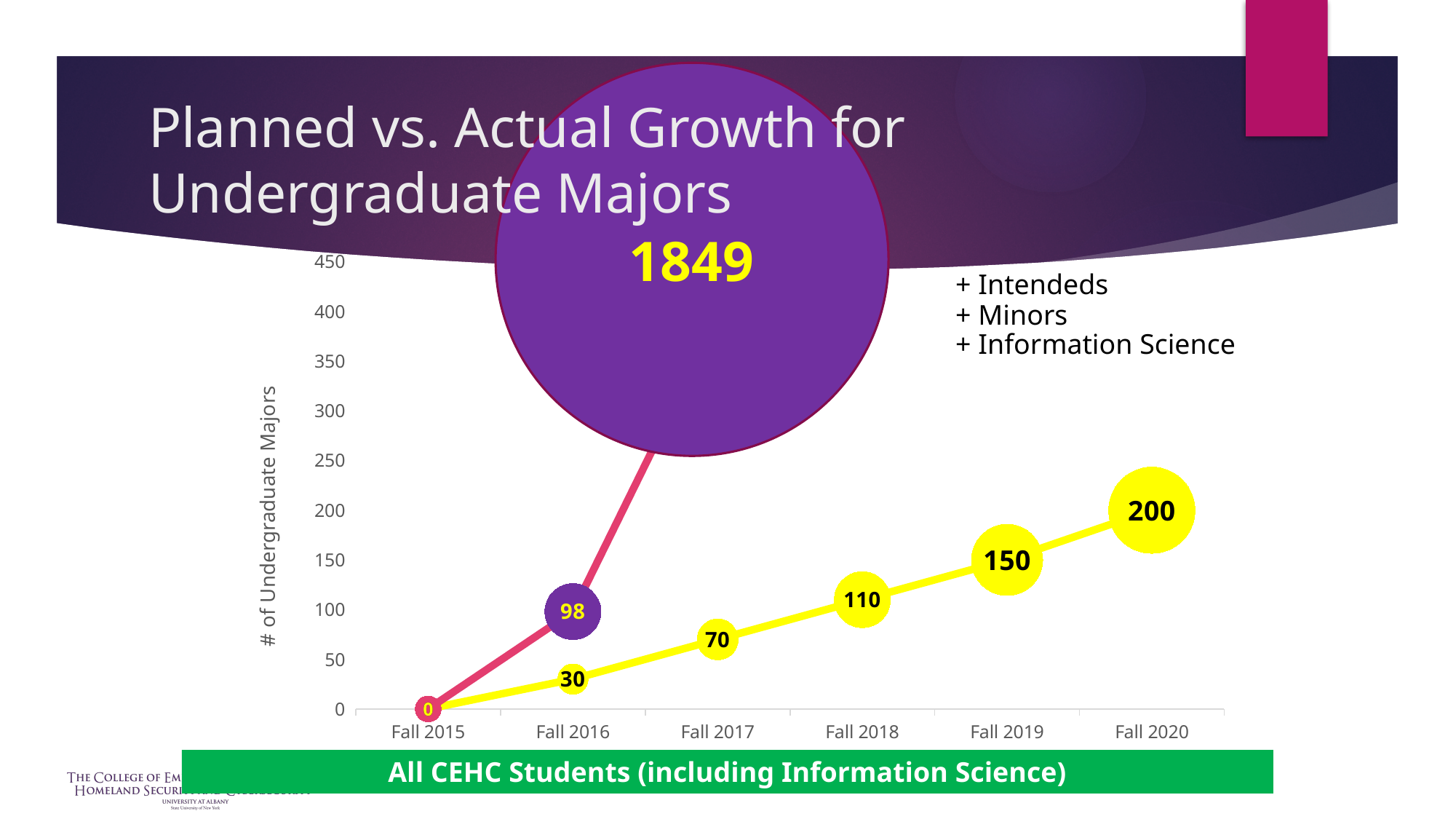
What is the difference between the yellow line values for Fall 2020 and Fall 2019? 50 What is the planned value (yellow line) for Fall 2020? 200 What value is shown on the pink line for Fall 2016? 98 What is the label of the y axis? # of Undergraduate Majors What is the difference between the pink line value and the yellow line value for Fall 2016? 68 What is the planned value (yellow line) for Fall 2019? 150 How many Fall terms are shown on the x axis? 6 What value is shown in the large purple circle at the top of the pink line? 1849 What is the planned value (yellow line) for Fall 2017? 70 Which Fall term has the highest value on the yellow line? Fall 2020 For Fall 2016, which is larger: the pink line value or the yellow line value? The pink line value Do the values on the yellow line rise or fall from Fall 2015 to Fall 2020? Rise